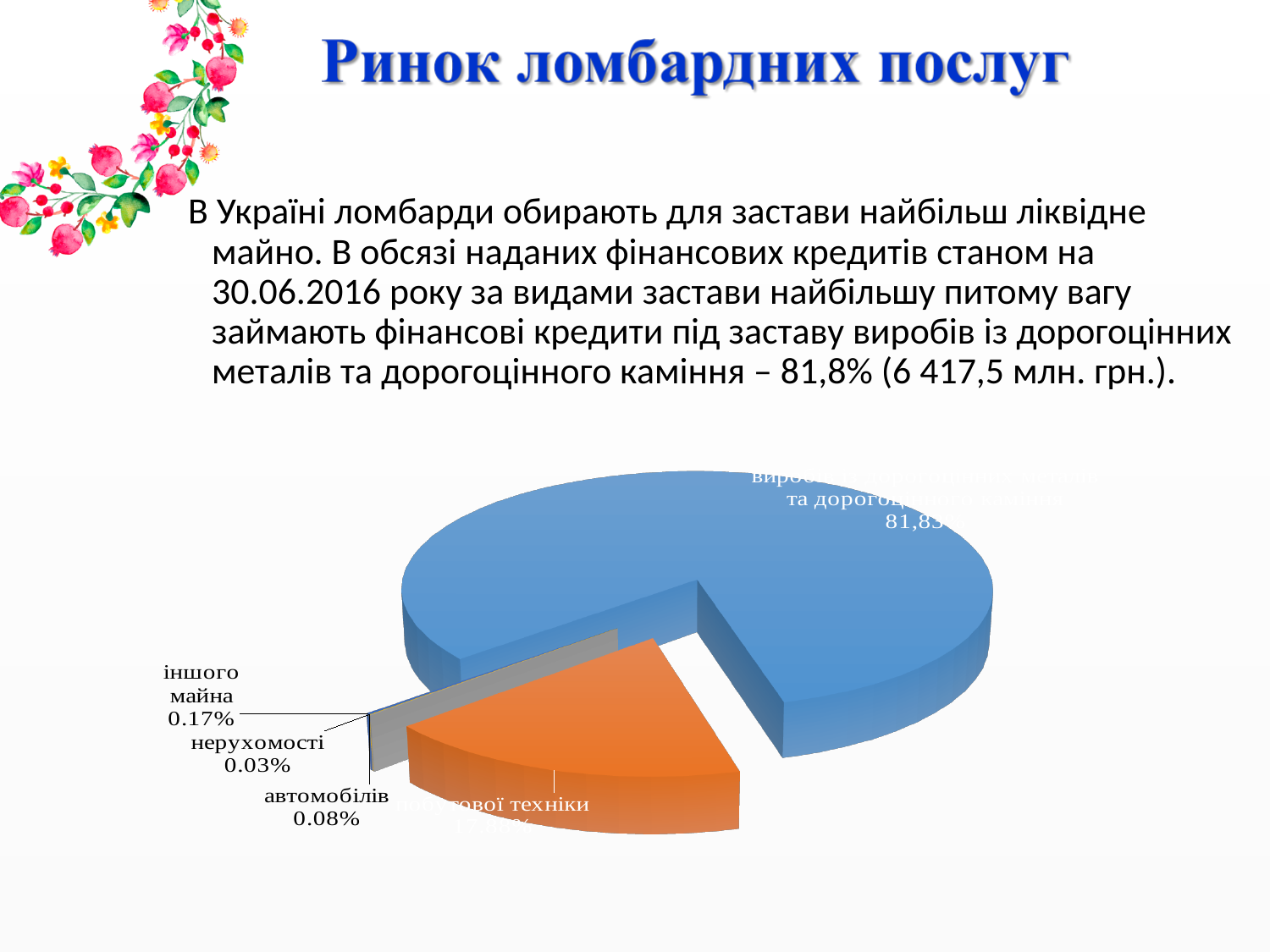
What is the share for нерухомості in the pie chart? 0.03% How many slices does the pie chart have? 5 What is the share for автомобілів in the pie chart? 0.08% What is the share for іншого майна in the pie chart? 0.17% Which category has the largest slice in the pie chart? виробів із дорогоцінних металів та дорогоцінного каміння Which is larger in the pie chart: іншого майна or автомобілів? іншого майна What colour is the slice for побутової техніки? orange Which category has the smallest slice in the pie chart? нерухомості What is the difference between the shares for автомобілів and нерухомості? 0.05% Which is larger in the pie chart: побутової техніки or іншого майна? побутової техніки What is the difference between the shares for іншого майна and нерухомості? 0.14% What kind of chart is shown on the slide? pie chart